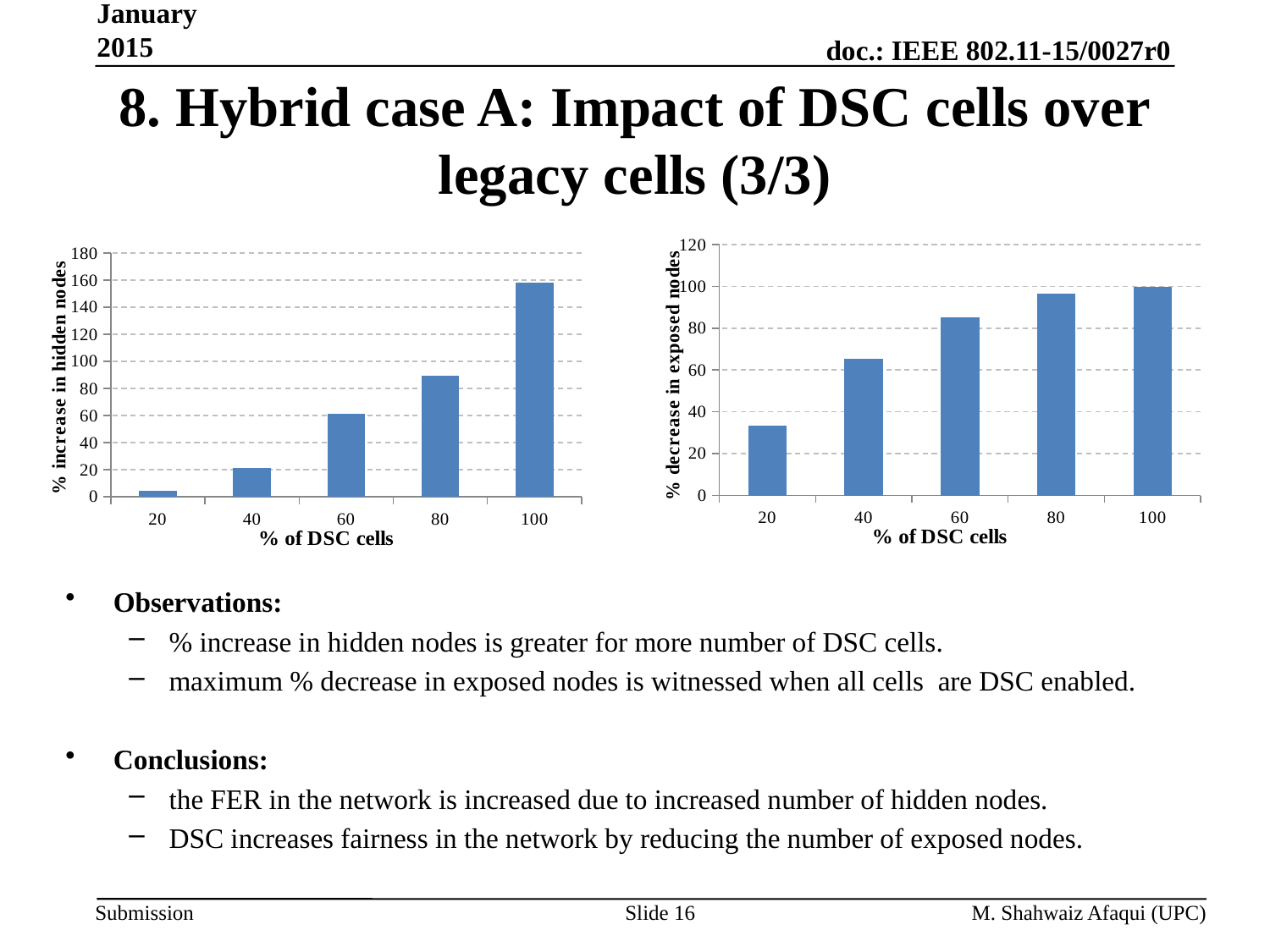
What kind of chart is the left chart (% increase in hidden nodes)? bar chart On the right chart (% decrease in exposed nodes), which is larger, the value for 40% of DSC cells or the value for 80% of DSC cells? 80 On the left chart (% increase in hidden nodes), is the value for 40% of DSC cells greater or less than 40? less On the left chart (% increase in hidden nodes), do the values rise or fall as the % of DSC cells increases? rise On the left chart (% increase in hidden nodes), is the value for 100% of DSC cells greater or less than 140? greater On the right chart (% decrease in exposed nodes), is the value for 60% of DSC cells greater or less than 80? greater On the left chart (% increase in hidden nodes), which % of DSC cells has the lowest value? 20 How many categories are shown on the x axis of the right chart (% decrease in exposed nodes)? 5 On the right chart (% decrease in exposed nodes), which % of DSC cells has the lowest value? 20 On the left chart (% increase in hidden nodes), which % of DSC cells has the highest value? 100